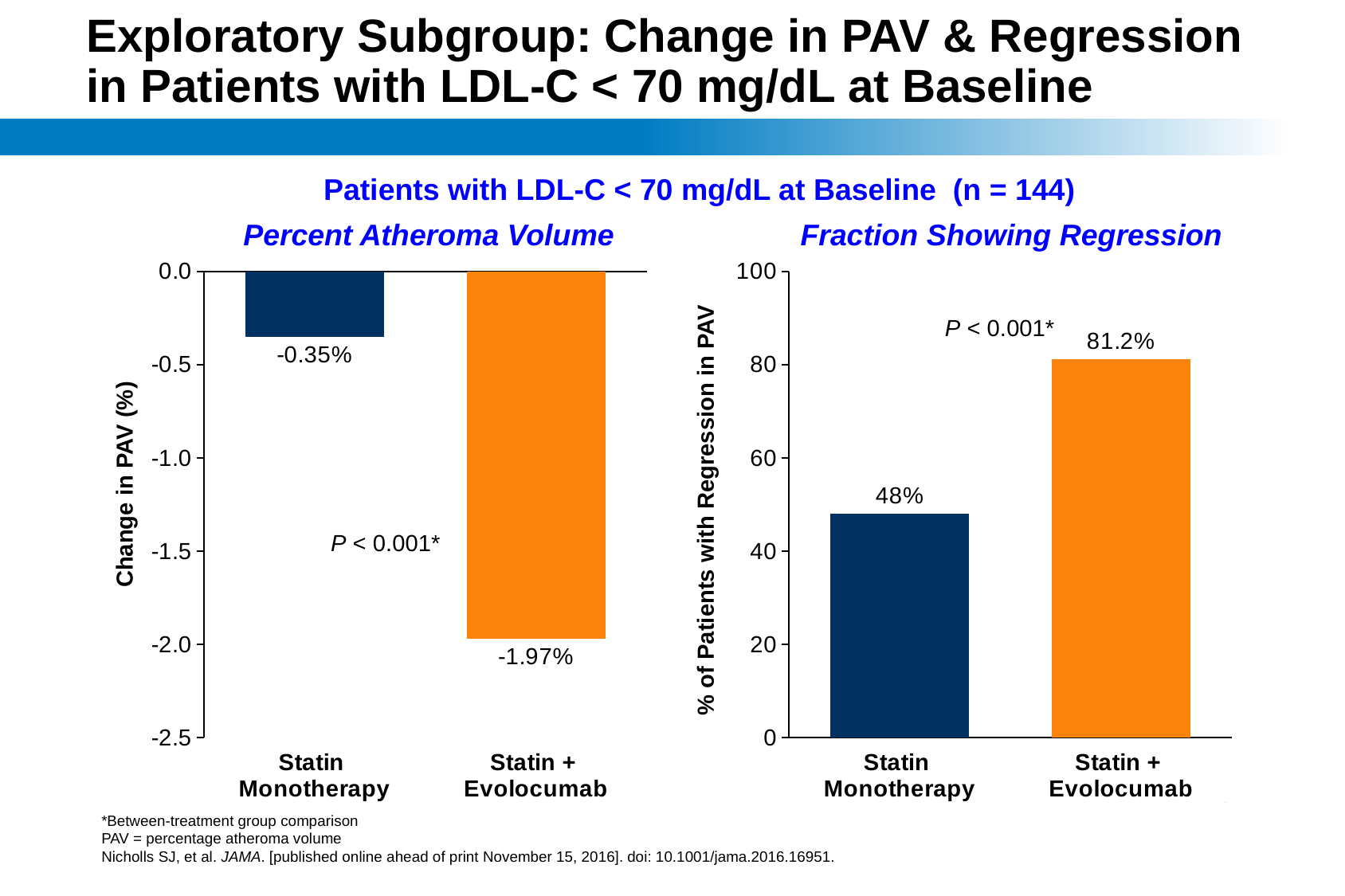
In the Fraction Showing Regression chart, what percentage of patients showed regression with Statin Monotherapy? 48% What type of chart is the Fraction Showing Regression chart? Bar chart In the Percent Atheroma Volume chart, what is the difference between the change in PAV for Statin + Evolocumab and Statin Monotherapy? 1.62% In the Fraction Showing Regression chart, is the value for Statin Monotherapy greater or less than 60? less In the Percent Atheroma Volume chart, what is the change in PAV for Statin + Evolocumab? -1.97% In the Percent Atheroma Volume chart, which treatment group shows the larger decrease in PAV? Statin + Evolocumab What is the y-axis label of the Percent Atheroma Volume chart? Change in PAV (%) In the Fraction Showing Regression chart, what percentage of patients showed regression with Statin + Evolocumab? 81.2% In the Fraction Showing Regression chart, what is the difference in percentage points between Statin + Evolocumab and Statin Monotherapy? 33.2 How many treatment groups are shown in the Percent Atheroma Volume chart? 2 In the Percent Atheroma Volume chart, what is the change in PAV for Statin Monotherapy? -0.35% In the Fraction Showing Regression chart, which treatment group has the higher percentage of patients with regression? Statin + Evolocumab